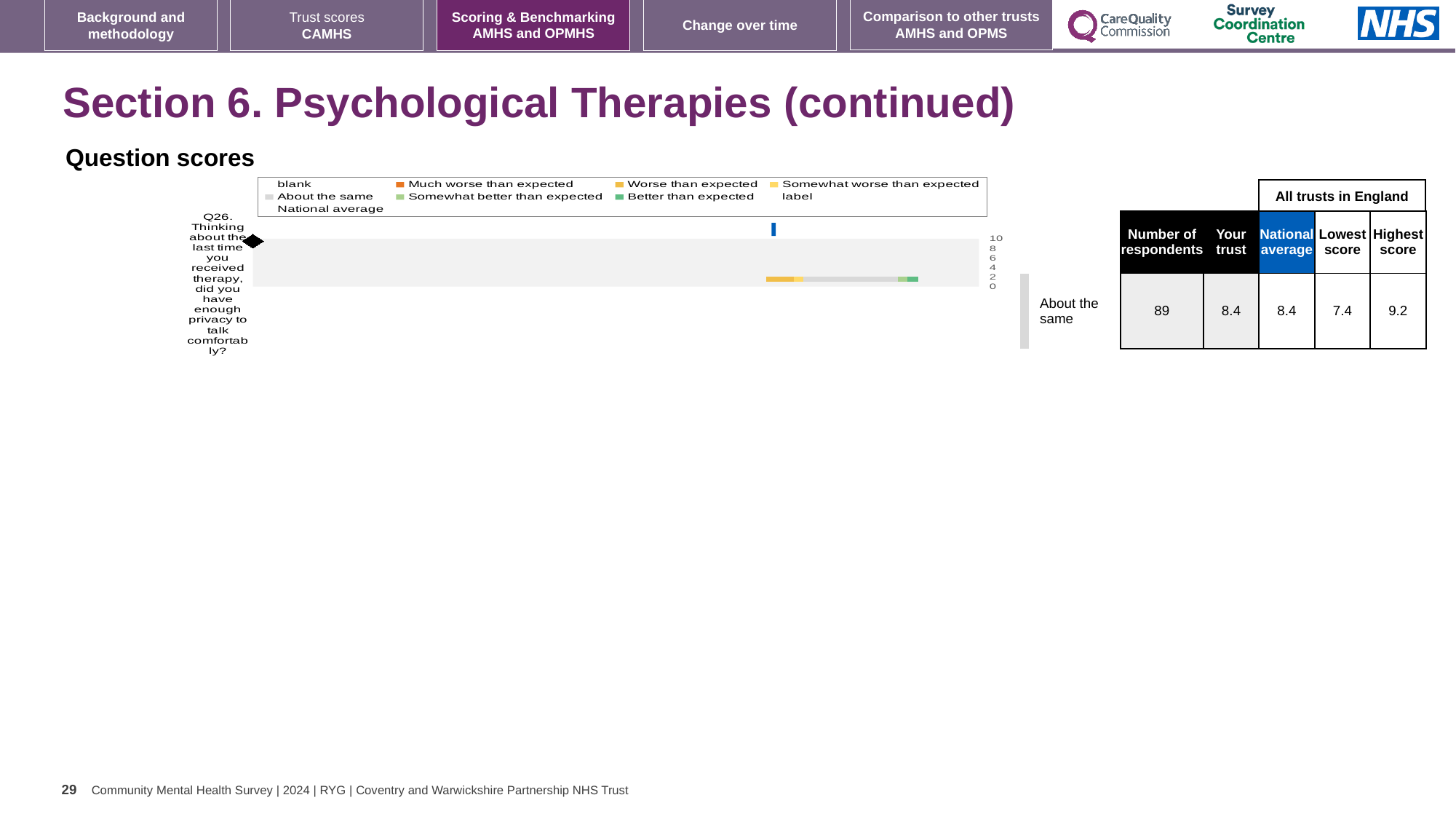
What is the highest tick value shown on the chart's axis? 10 According to the table beside the chart, what is the 'Your trust' score for Q26? 8.4 What kind of chart is shown under 'Question scores'? bar chart According to the table beside the chart, what is the Lowest score across all trusts in England for Q26? 7.4 What is the difference between the Highest score and the Lowest score for Q26 in the table beside the chart? 1.8 According to the table beside the chart, what is the Highest score across all trusts in England for Q26? 9.2 Is the 'Your trust' score for Q26 larger than, smaller than, or equal to the National average? equal According to the table beside the chart, what is the National average for Q26? 8.4 How many questions (categories) are plotted on the chart? 1 According to the table beside the chart, how many respondents answered Q26? 89 Which question is plotted on the chart? Q26. Thinking about the last time you received therapy, did you have enough privacy to talk comfortably? What benchmark category is shown next to the chart for Q26? About the same